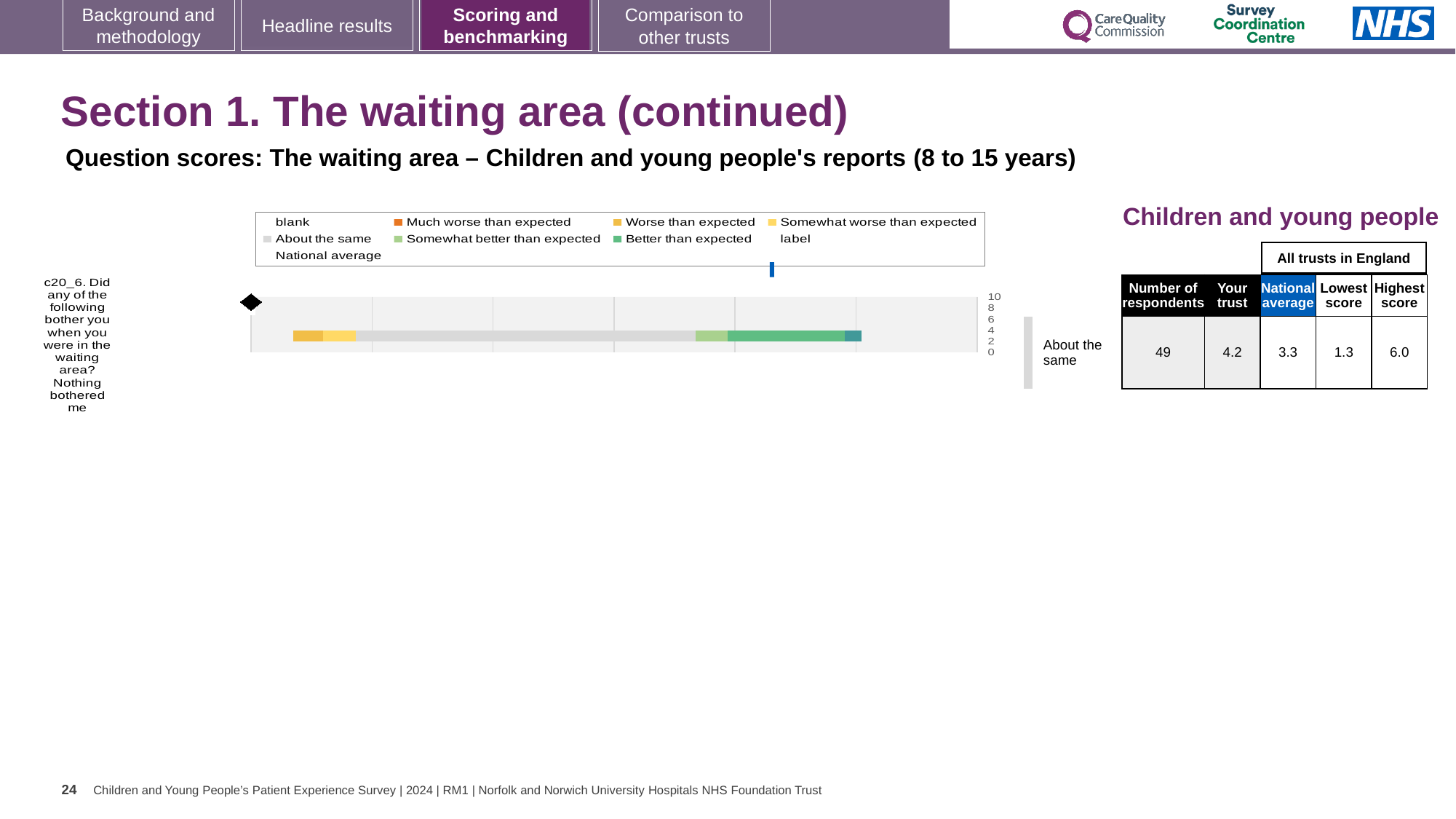
In the table beside the chart, what is the highest score among all trusts in England? 6.0 Which is larger for question c20_6: the 'Your trust' score or the national average? Your trust In the table beside the chart, what is the lowest score among all trusts in England? 1.3 What is the difference between the highest score and the lowest score for question c20_6? 4.7 What is the question code of the item plotted in the chart? c20_6 In the table beside the chart, what is the national average score for question c20_6? 3.3 What benchmark category is shown next to the bar for question c20_6? About the same How many respondents are reported for question c20_6? 49 What kind of chart is shown on the slide? bar chart How many survey questions are plotted in the chart? 1 In the table beside the chart, what is the 'Your trust' score for question c20_6? 4.2 What is the highest value shown on the chart's axis? 10